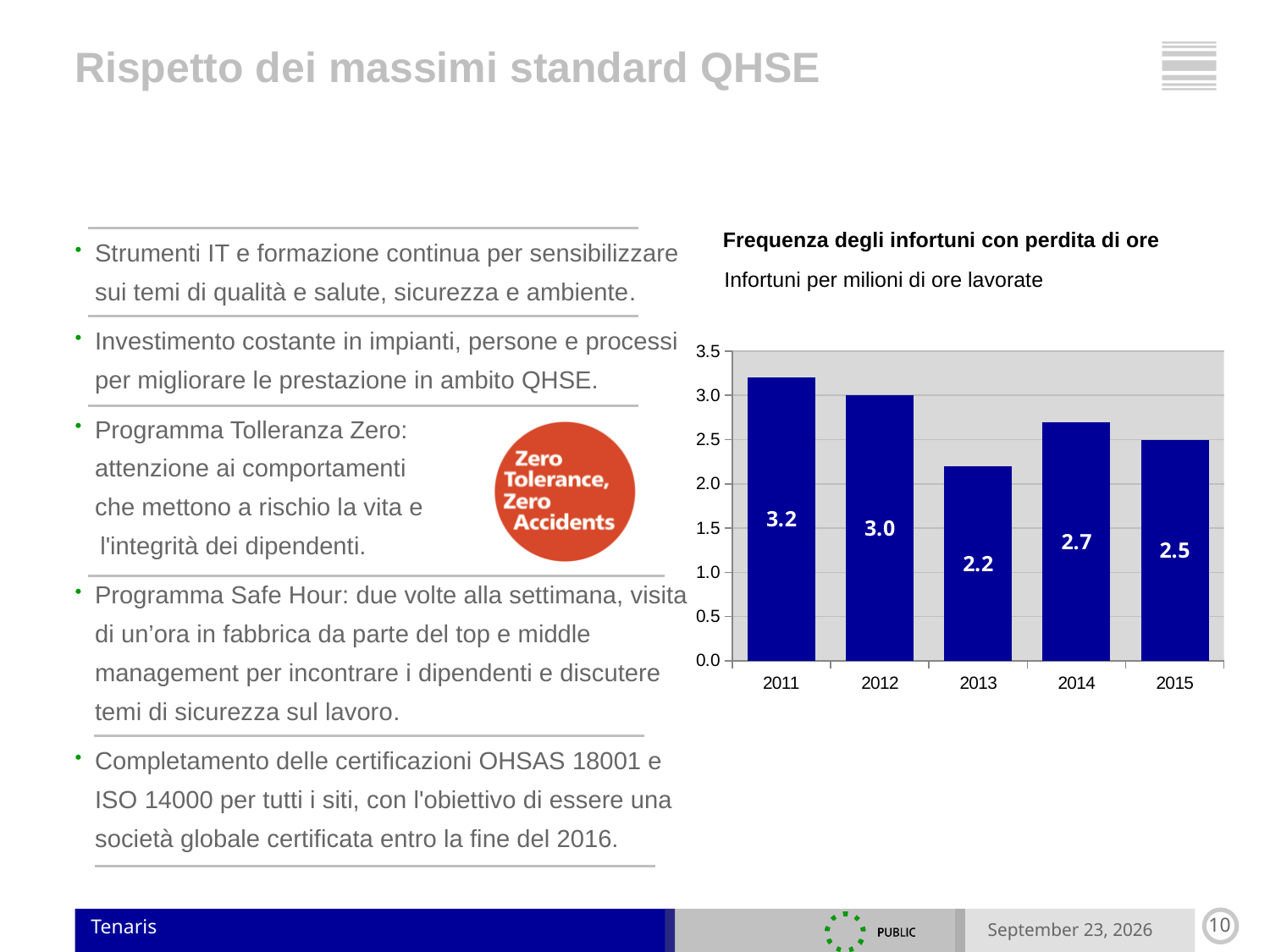
How many years are shown on the x axis? 5 What is the difference between the values for 2011 and 2015? 0.7 Which year has the highest value? 2011 What is the title of the chart? Frequenza degli infortuni con perdita di ore What is the value for 2013? 2.2 What is the value for 2011? 3.2 Which is larger, the value for 2012 or the value for 2014? 2012 Which year has the lowest value? 2013 What is the difference between the values for 2014 and 2013? 0.5 What is the value for 2015? 2.5 Is the value for 2014 greater or less than 2.5? greater What kind of chart is shown? bar chart